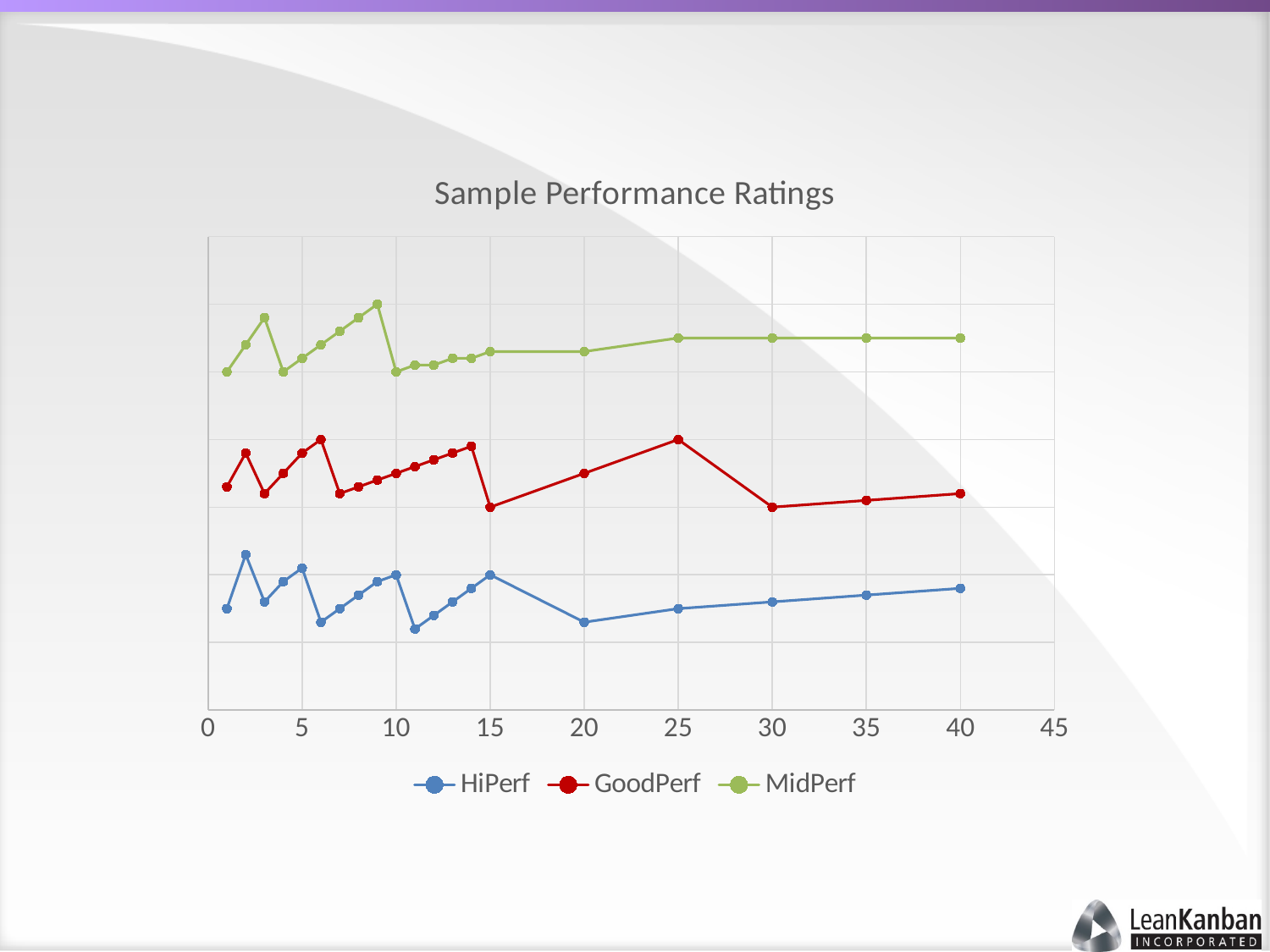
Which colour is used for the GoodPerf series? red How many series does the legend list? 3 What is the largest value labelled on the x axis? 45 How many data points does the HiPerf series have? 20 What kind of chart is shown on the slide? line chart At x = 25, which is higher, GoodPerf or HiPerf? GoodPerf Does the GoodPerf series rise or fall between x = 25 and x = 30? fall Which series is plotted lowest on the chart? HiPerf Does the HiPerf series rise or fall between x = 20 and x = 40? rise Which series is plotted highest on the chart? MidPerf What is the title of the chart? Sample Performance Ratings At x = 40, which is higher, MidPerf or GoodPerf? MidPerf